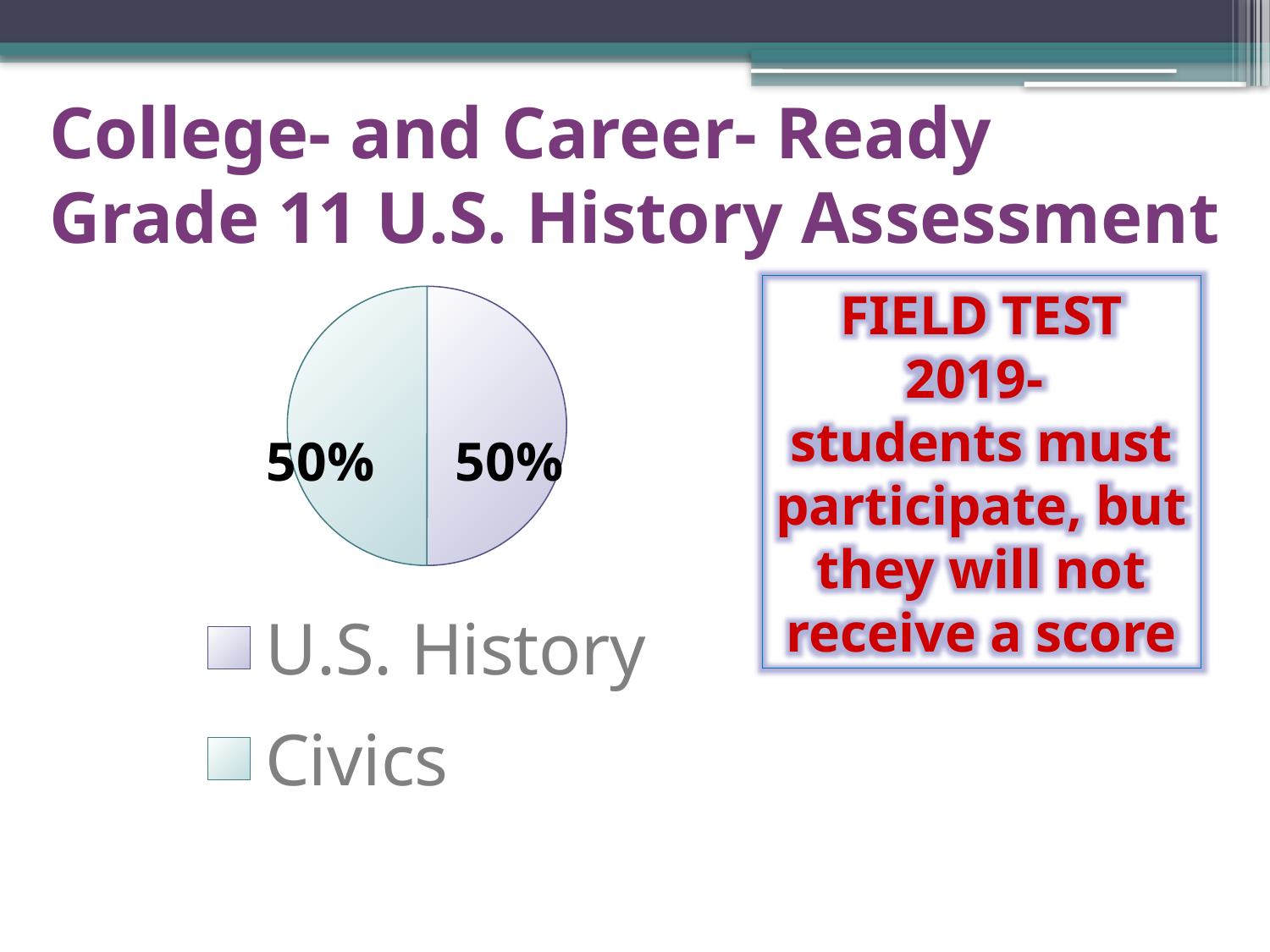
What share of the pie chart is U.S. History? 50% What is the difference between the U.S. History share and the Civics share? 0% Do the U.S. History and Civics slices have the same share of the pie? Yes Which legend entry is listed first in the pie chart's legend? U.S. History Which two categories are listed in the pie chart's legend? U.S. History and Civics What value is labelled on the Civics slice of the pie chart? 50% What kind of chart is shown on the slide? Pie chart How many entries does the legend of the pie chart list? 2 What share of the pie chart is Civics? 50% What do the two slices of the pie chart add up to? 100% How many slices does the pie chart have? 2